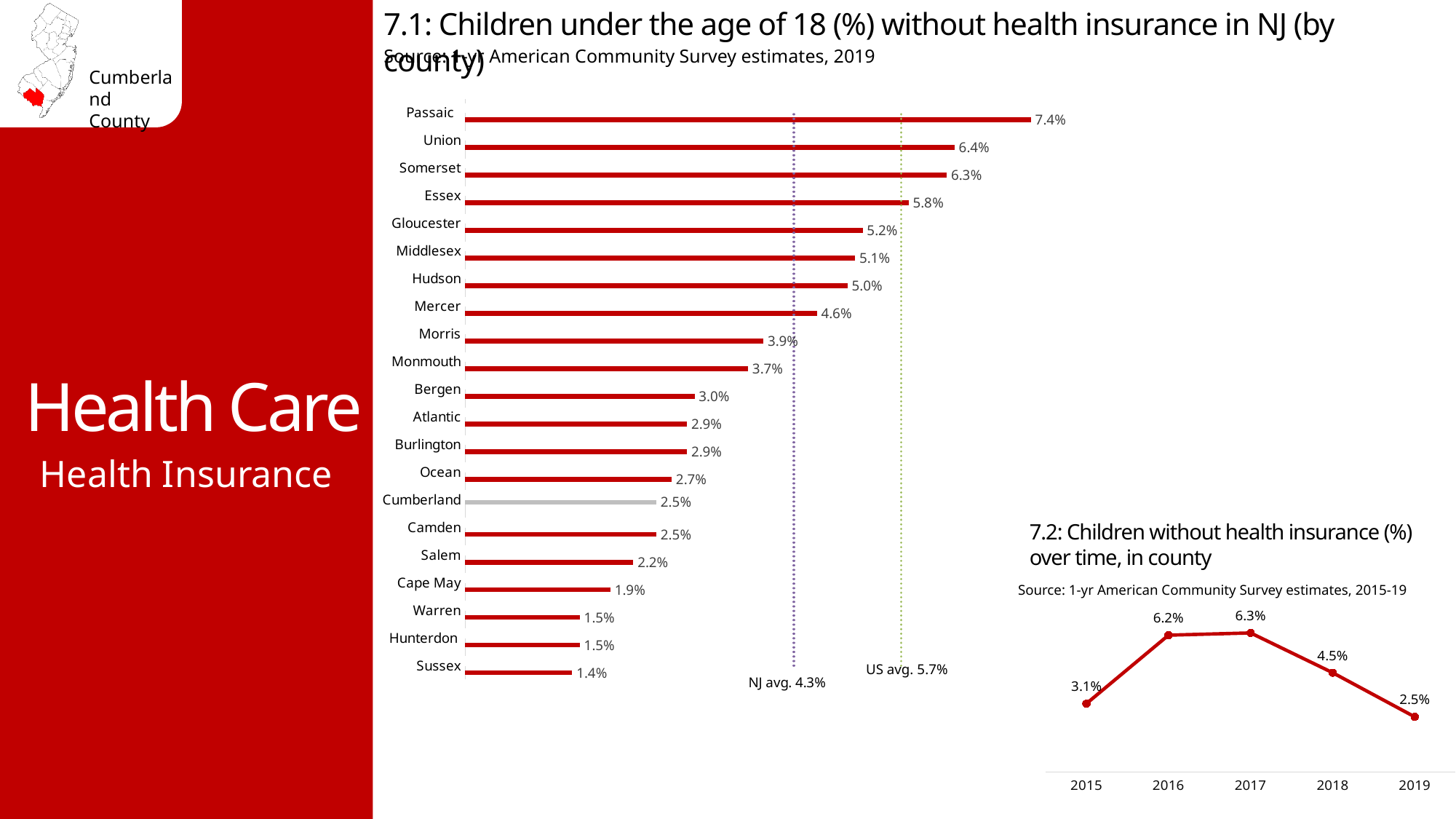
In chart 7.2, what is the value for 2017? 6.3% In chart 7.1, what is the value for Passaic? 7.4% In chart 7.1, what is the NJ average shown by the dotted line? 4.3% In chart 7.1, how many counties are plotted? 21 In chart 7.1, which is larger, the value for Gloucester or the value for Mercer? Gloucester In chart 7.1, what is the value for Cumberland? 2.5% In chart 7.2, what is the difference between 2017 and 2019? 3.8% In chart 7.1, which county has the lowest value? Sussex In chart 7.2, which year has the lowest value? 2019 What kind of chart is chart 7.1? Bar chart In chart 7.1, which county has the highest value? Passaic In chart 7.1, what is the difference between Passaic and Sussex? 6.0%